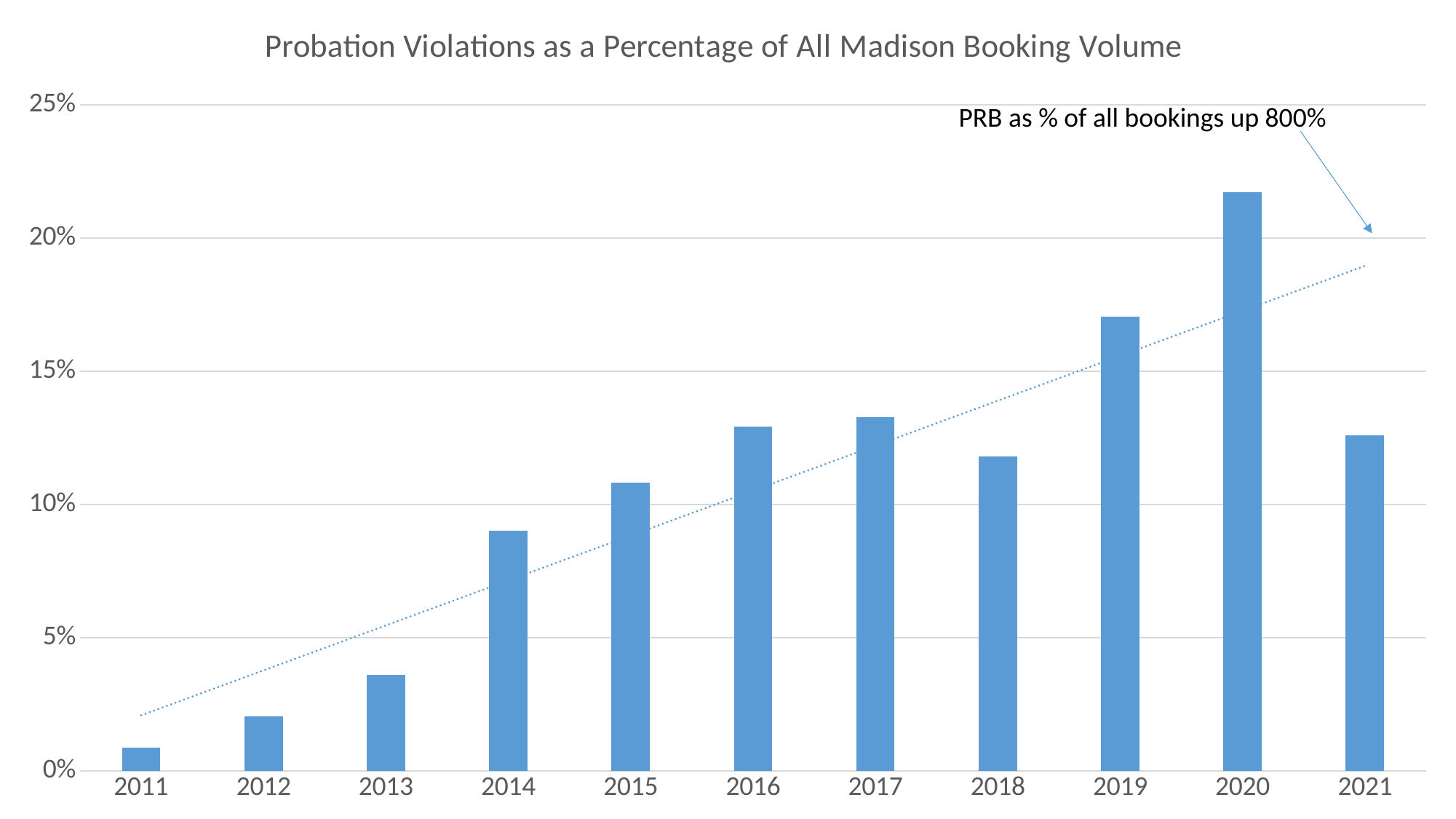
What kind of chart is shown on the slide? bar chart Which year has the highest bar in the chart? 2020 Is the value for 2013 greater or less than 5%? less What is the title of the chart? Probation Violations as a Percentage of All Madison Booking Volume How many years are shown on the x axis of the chart? 11 Is the value for 2014 greater or less than 10%? less Is the value for 2020 greater or less than 20%? greater What does the annotation text on the chart say? PRB as % of all bookings up 800% Do the values generally rise or fall from 2011 to 2020? rise Which year has the larger value, 2019 or 2021? 2019 Which year has the lowest bar in the chart? 2011